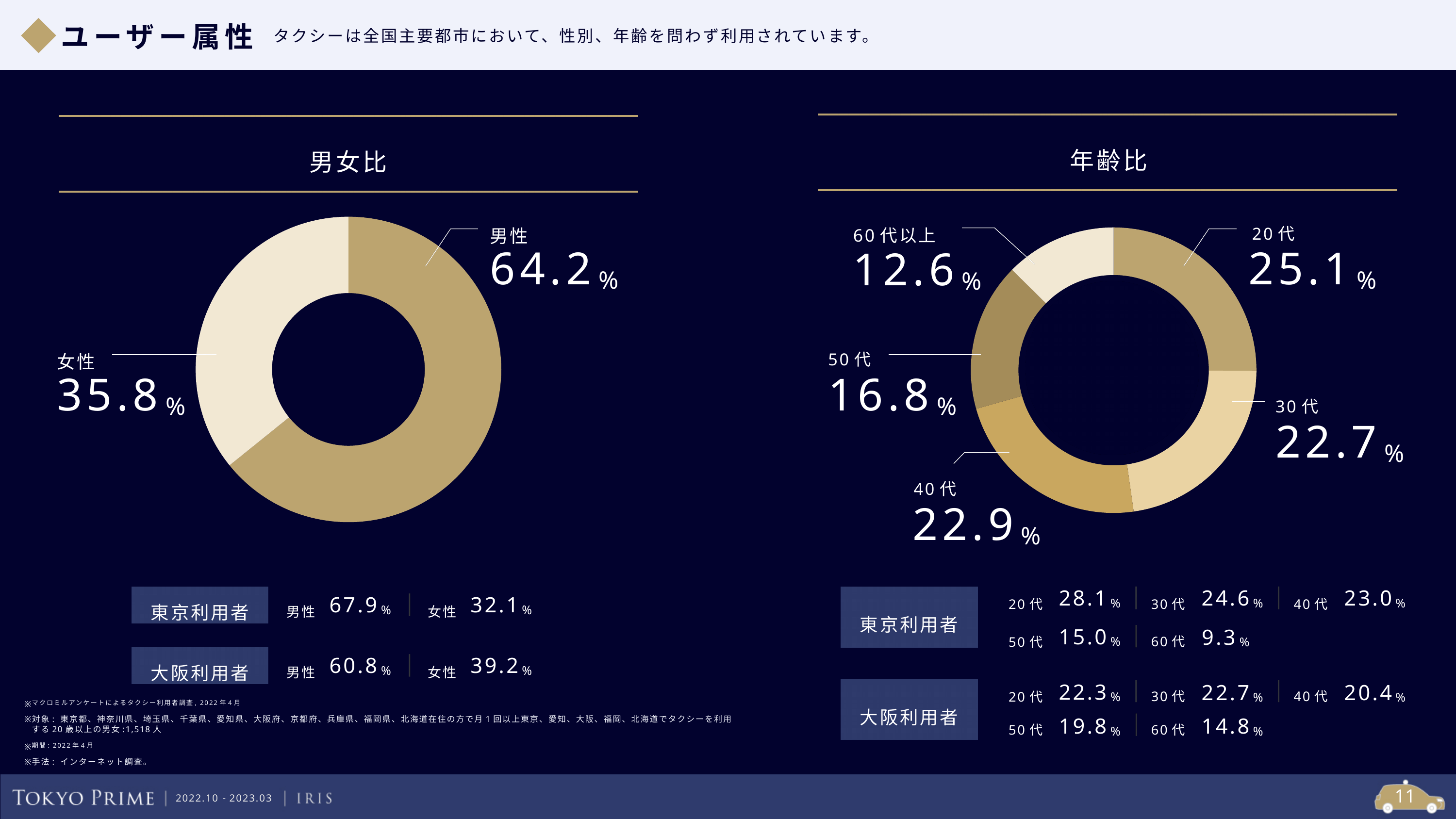
In the 年齢比 chart, what percentage is 50代? 16.8% In the 男女比 chart, what is the difference between the 男性 and 女性 shares? 28.4% In the 年齢比 chart, how many age groups are shown? 5 In the 男女比 chart, what percentage is 女性? 35.8% In the 男女比 chart, what percentage is 男性? 64.2% What kind of chart is the 男女比 chart? Donut (pie) chart In the 年齢比 chart, what percentage is 20代? 25.1% In the 年齢比 chart, which age group has the smallest share? 60代以上 In the 年齢比 chart, is the share for 20代 larger or smaller than the share for 50代? Larger In the 年齢比 chart, what is the difference between the 40代 and 30代 shares? 0.2% In the 年齢比 chart, which age group has the largest share? 20代 In the 年齢比 chart, what percentage is 60代以上? 12.6%